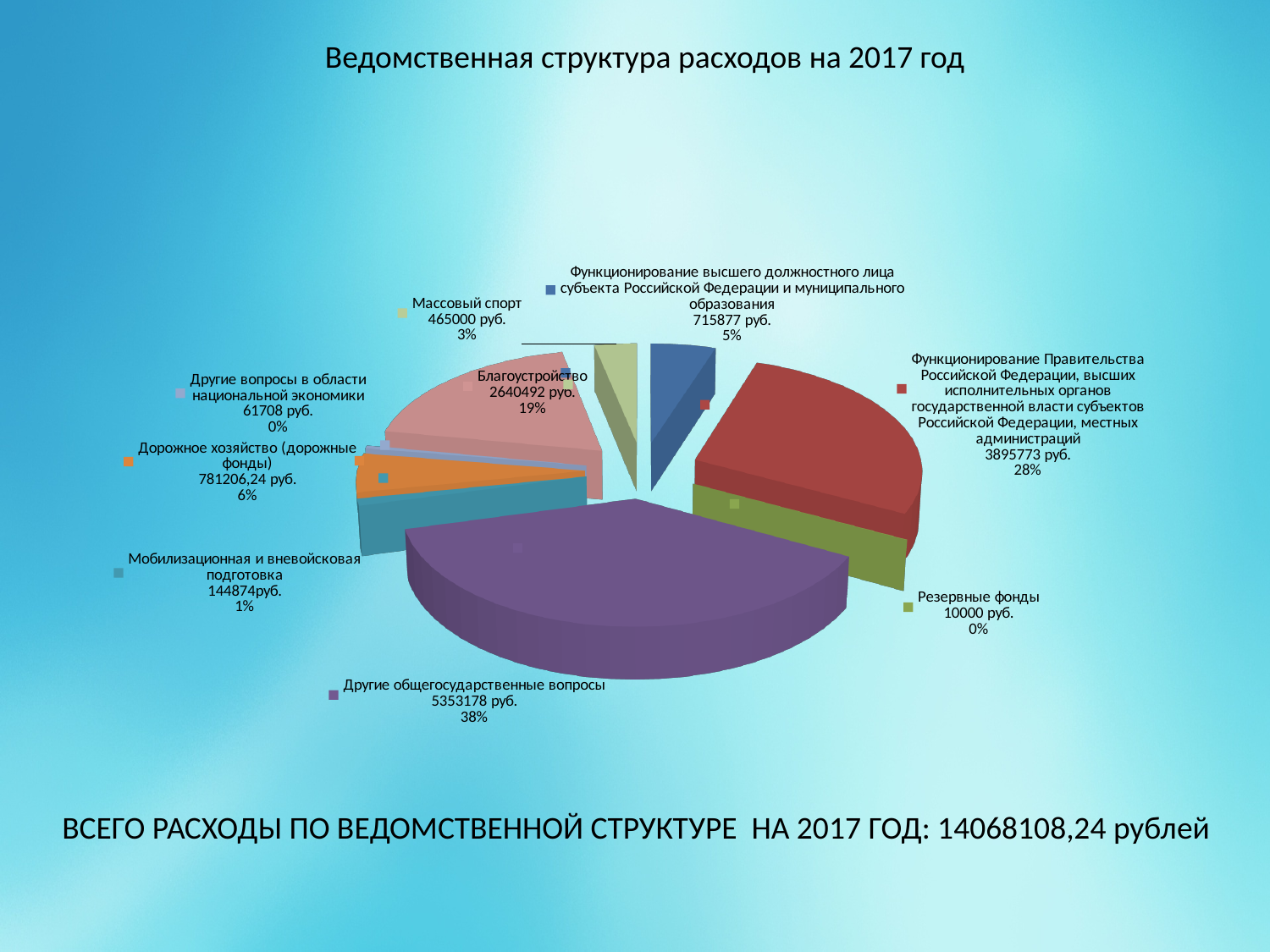
What is the value shown for Массовый спорт? 465000 руб. What is the value shown for Дорожное хозяйство (дорожные фонды)? 781206,24 руб. What percentage share does Функционирование Правительства Российской Федерации, высших исполнительных органов государственной власти субъектов Российской Федерации, местных администраций have? 28% What is the title of the chart? Ведомственная структура расходов на 2017 год What percentage share does Другие общегосударственные вопросы have? 38% What kind of chart is shown on the slide? Pie chart How many slices does the pie chart have? 9 Which category has the smallest value? Резервные фонды Which category has the largest slice of the pie? Другие общегосударственные вопросы What is the difference between the values for Другие общегосударственные вопросы and Благоустройство? 2712686 руб. What is the value shown for Благоустройство? 2640492 руб. Which is larger: Благоустройство or Массовый спорт? Благоустройство